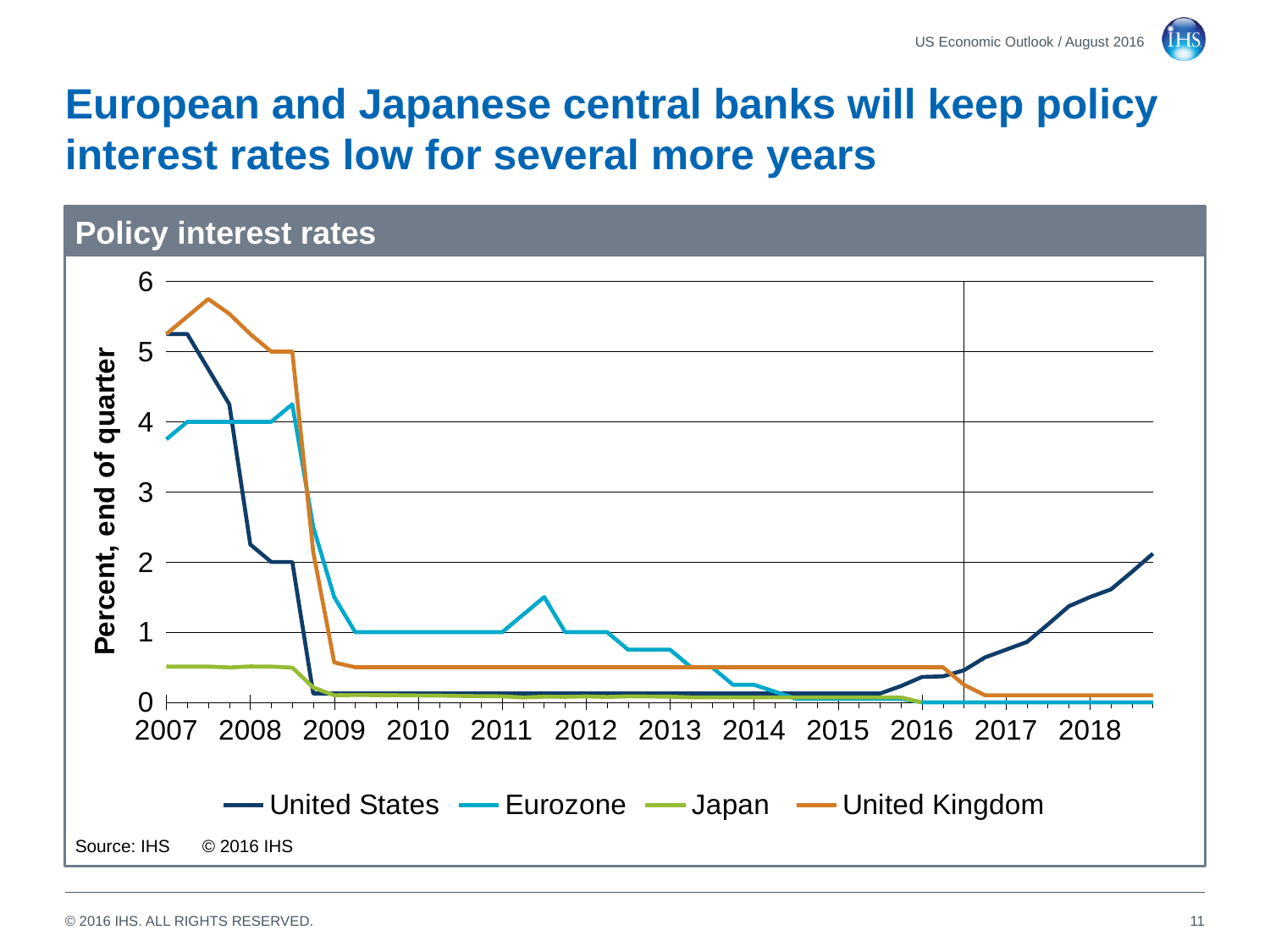
In 2018, which is higher, the United States or the United Kingdom? United States What is the title of the chart? Policy interest rates What is the label on the vertical axis? Percent, end of quarter Is the value for Japan in 2012 greater or less than 1? less Which series reaches the highest value anywhere on the chart? United Kingdom Is the value for the Eurozone in 2010 greater or less than 2? less What kind of chart is shown on the slide? line chart Does the United States line rise or fall from 2016 to 2018? rise How many series does the legend list? 4 Is the value for the United States at the end of 2018 greater or less than 1? greater In 2007, which is higher, the United States or the Eurozone? United States